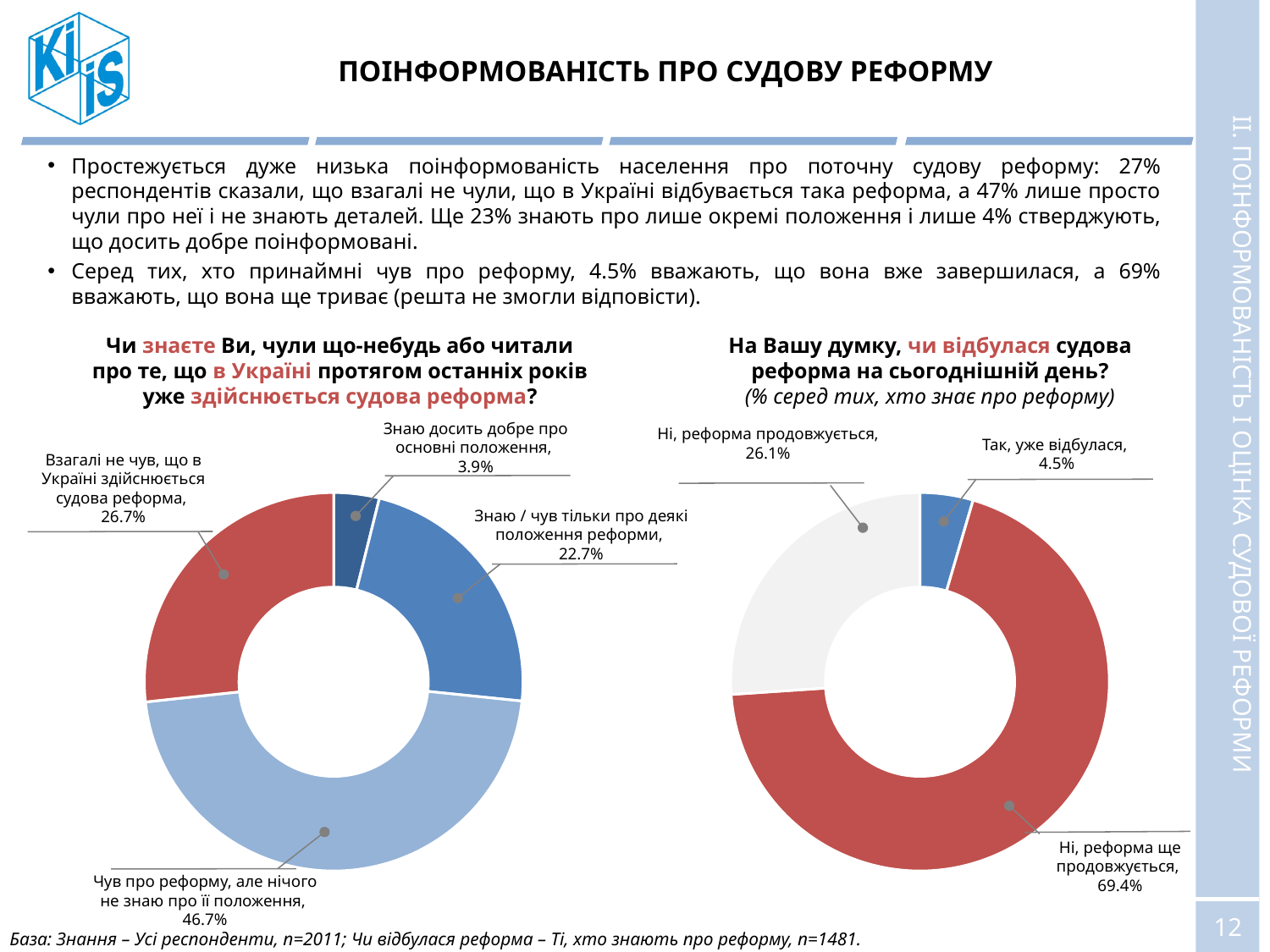
In the left chart, which category has the smallest share? Знаю досить добре про основні положення In the left chart, what share of respondents said 'Взагалі не чув, що в Україні здійснюється судова реформа'? 26.7% How many categories are shown in the left chart? 4 In the right chart, what percentage answered 'Так, уже відбулася'? 4.5% In the right chart, what value is shown for the grey slice? 26.1% In the left chart, what percentage answered 'Знаю досить добре про основні положення'? 3.9% What type of chart is used on the left side of the slide? Donut (pie) chart In the left chart, what percentage of respondents answered 'Чув про реформу, але нічого не знаю про її положення'? 46.7% In the right chart, which is larger: 'Так, уже відбулася' or 'Ні, реформа ще продовжується'? Ні, реформа ще продовжується In the left chart, what is the difference between 'Взагалі не чув' (26.7%) and 'Знаю / чув тільки про деякі положення реформи' (22.7%)? 4 percentage points In the right chart, what percentage answered 'Ні, реформа ще продовжується'? 69.4% In the left chart, which category has the largest share? Чув про реформу, але нічого не знаю про її положення